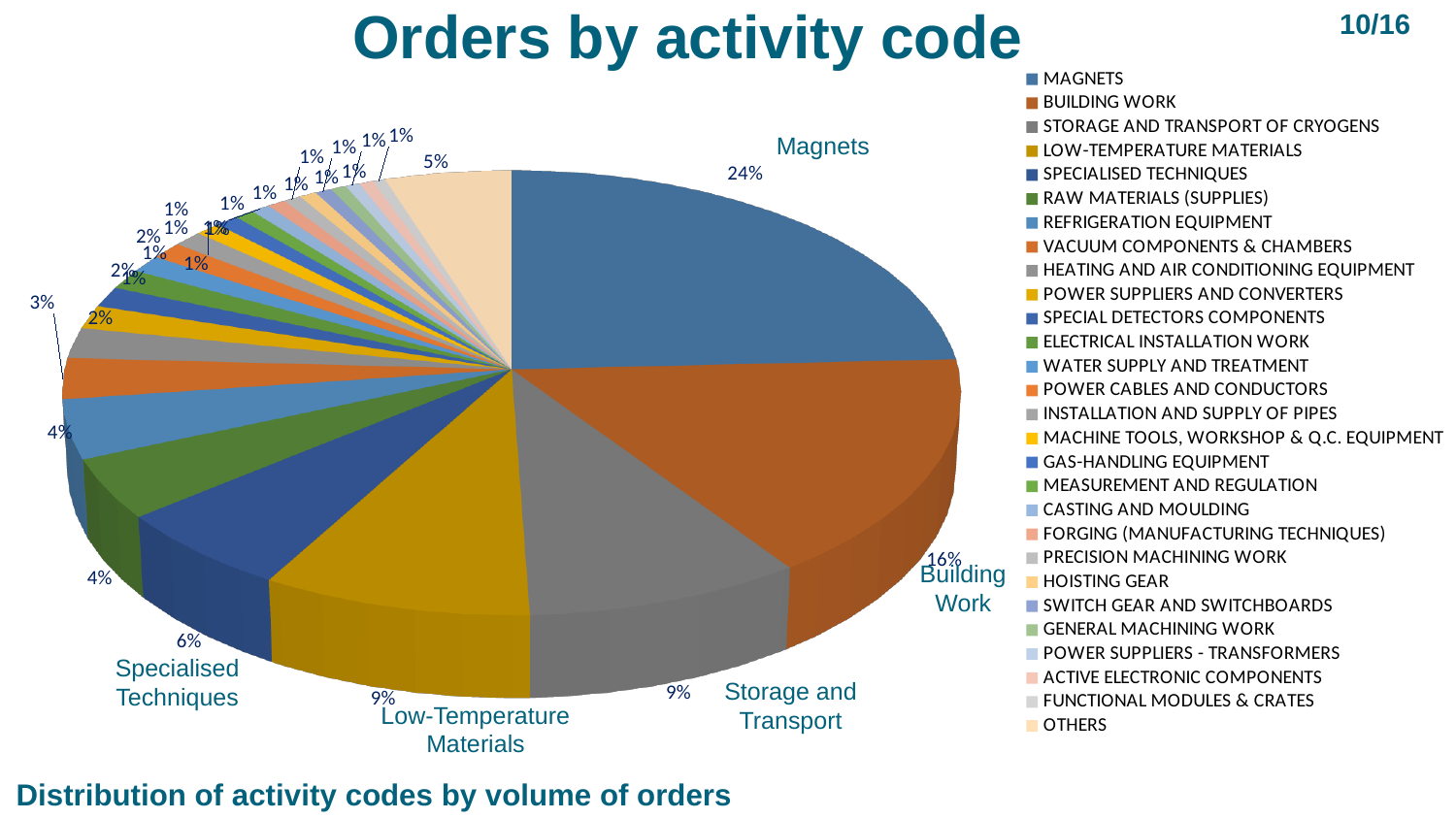
Which activity code has the largest share of orders? Magnets What percentage is shown for Building Work? 16% What is the title of the chart? Orders by activity code What kind of chart is shown on the slide? Pie chart What percentage is shown for Storage and Transport? 9% What is the first entry listed in the legend? MAGNETS What share of orders does the Magnets slice represent? 24% What percentage is shown for Low-Temperature Materials? 9% What percentage is shown for Specialised Techniques? 6% How many percentage points larger is the Magnets share than the Building Work share? 8 Which has a larger share of orders, Building Work or Specialised Techniques? Building Work What is the combined share of Magnets and Building Work? 40%